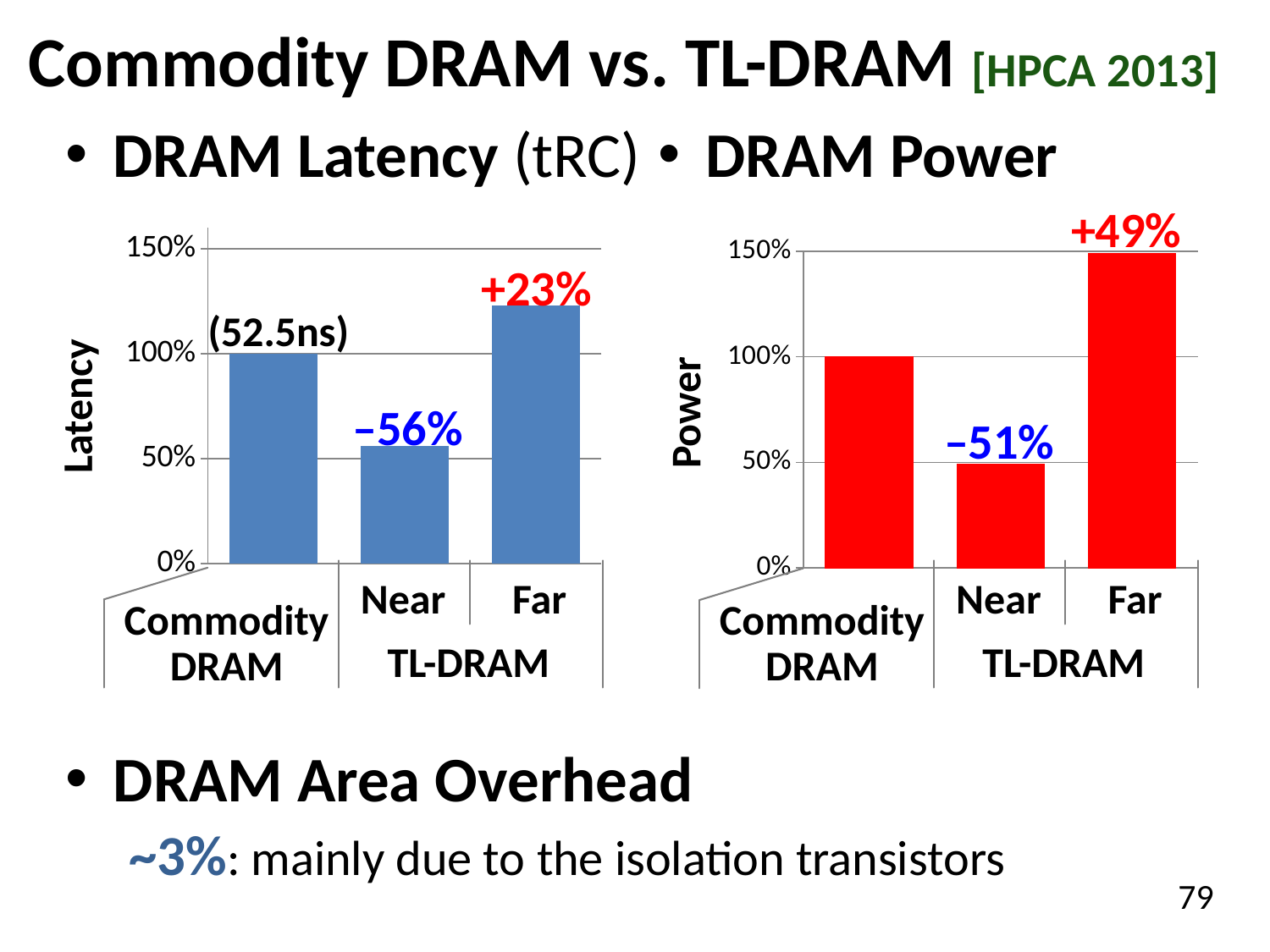
In the DRAM Power chart, is the value for the Far TL-DRAM bar greater or less than 100%? greater In the DRAM Latency chart, what absolute latency value is given in parentheses for Commodity DRAM? 52.5ns In the DRAM Power chart, what percentage change is labelled above the Near TL-DRAM bar? –51% In the DRAM Latency chart, what percentage change is labelled above the Near TL-DRAM bar? –56% In the DRAM Latency chart, what percentage change is labelled above the Far TL-DRAM bar? +23% In the DRAM Latency chart, which bar is the lowest? Near What colour are the bars in the DRAM Power chart? red In the DRAM Latency chart, how many bars are plotted? 3 What kind of chart is the DRAM Latency chart on the left? bar chart In the DRAM Power chart, what percentage change is labelled above the Far TL-DRAM bar? +49% In the DRAM Power chart, which bar is the highest? Far In the DRAM Latency chart, is the value for the Near TL-DRAM bar greater or less than 50%? greater